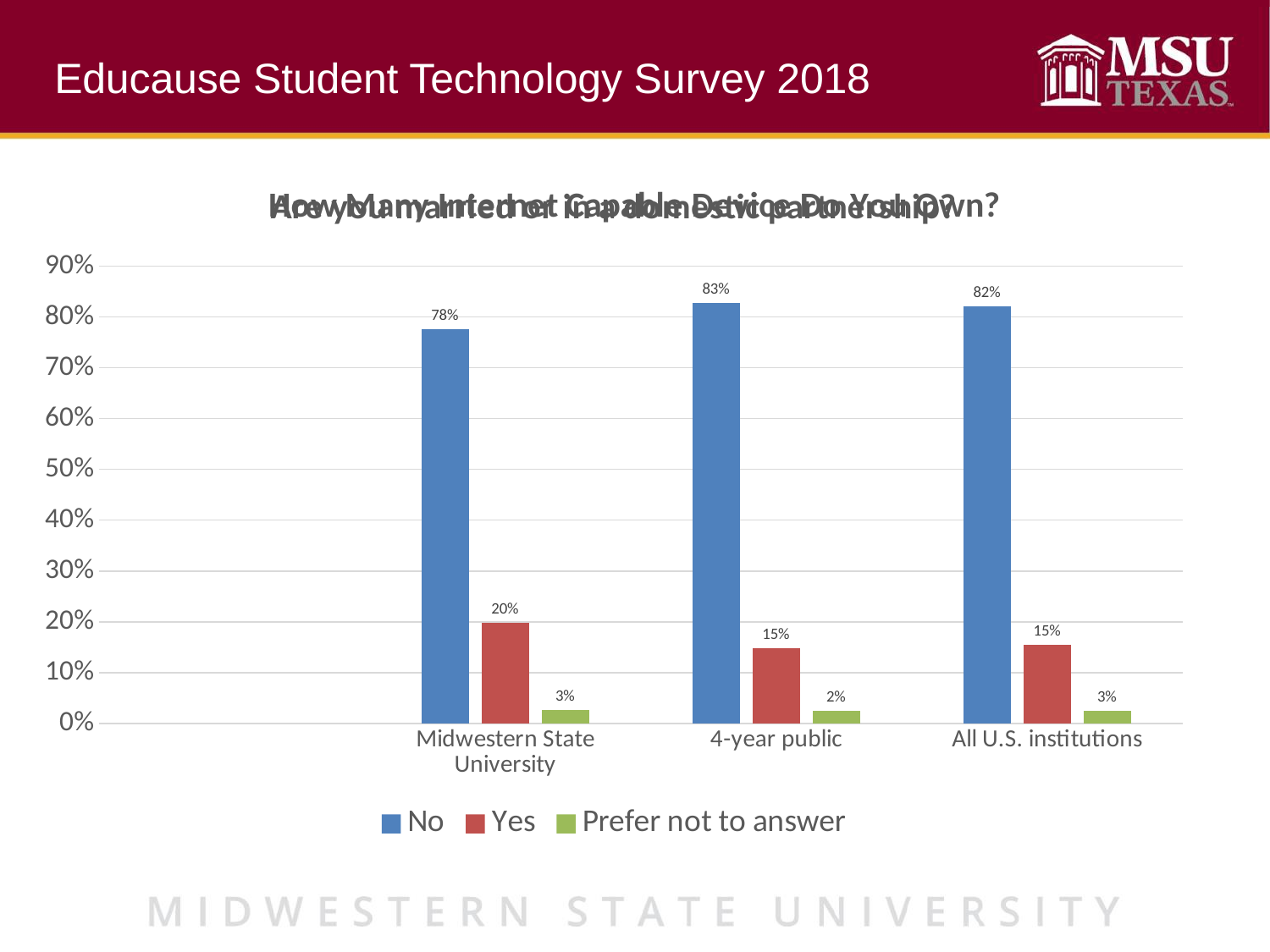
Which is larger: the "Yes" value for Midwestern State University or for All U.S. institutions? Midwestern State University How many categories are shown on the x axis? 3 What kind of chart is shown on the slide? bar chart What is the value for "Yes" at Midwestern State University? 20% How many series does the legend list? 3 What is the difference between the "No" values for 4-year public and Midwestern State University? 5% What is the value for "Yes" at 4-year public institutions? 15% Is the value for "No" at All U.S. institutions greater or less than 80%? greater What is the value for "Prefer not to answer" at All U.S. institutions? 3% Which category has the highest value for "No"? 4-year public Which category has the lowest value for "Prefer not to answer"? 4-year public What is the value for "No" at Midwestern State University? 78%